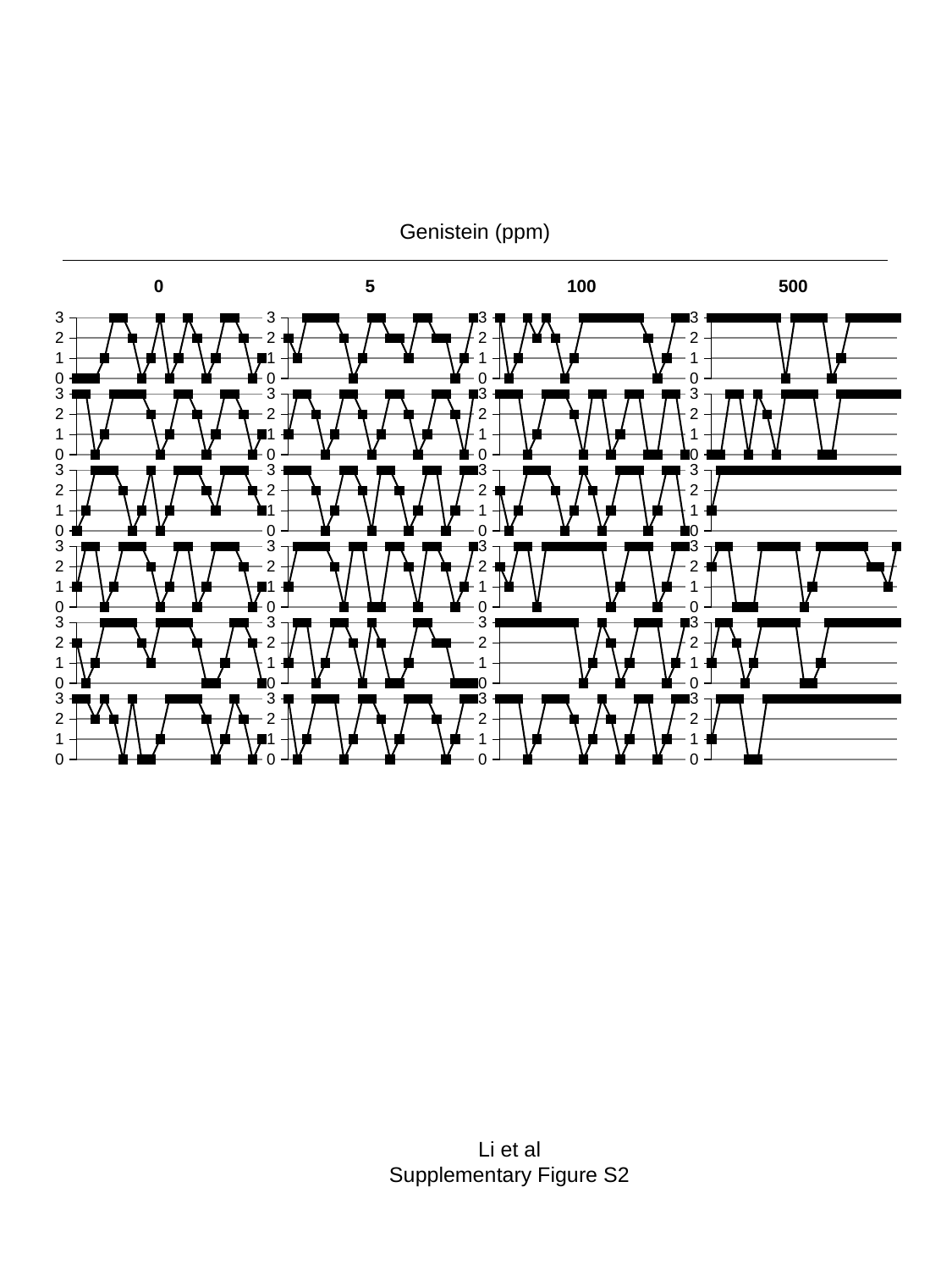
How many small charts are there in total on the slide? 24 How many columns of charts are there on the slide? 4 In the 500 column, bottom chart, what is the lowest value the line reaches? 0 What are the four column headings above the charts? 0, 5, 100, 500 What is the overall title printed above the grid of charts? Genistein (ppm) In the 100 column, fifth chart from the top, what is the value of the first point? 3 What kind of charts are shown on the slide? line chart How many rows of charts are there on the slide? 6 In the 0 column, top chart, what is the value of the first point? 0 In the 500 column, third chart from the top, what is the value of the first point? 1 In the 500 column, top chart, what is the lowest value the line reaches? 0 In the 500 column, third chart from the top, what is the highest value the line reaches? 3